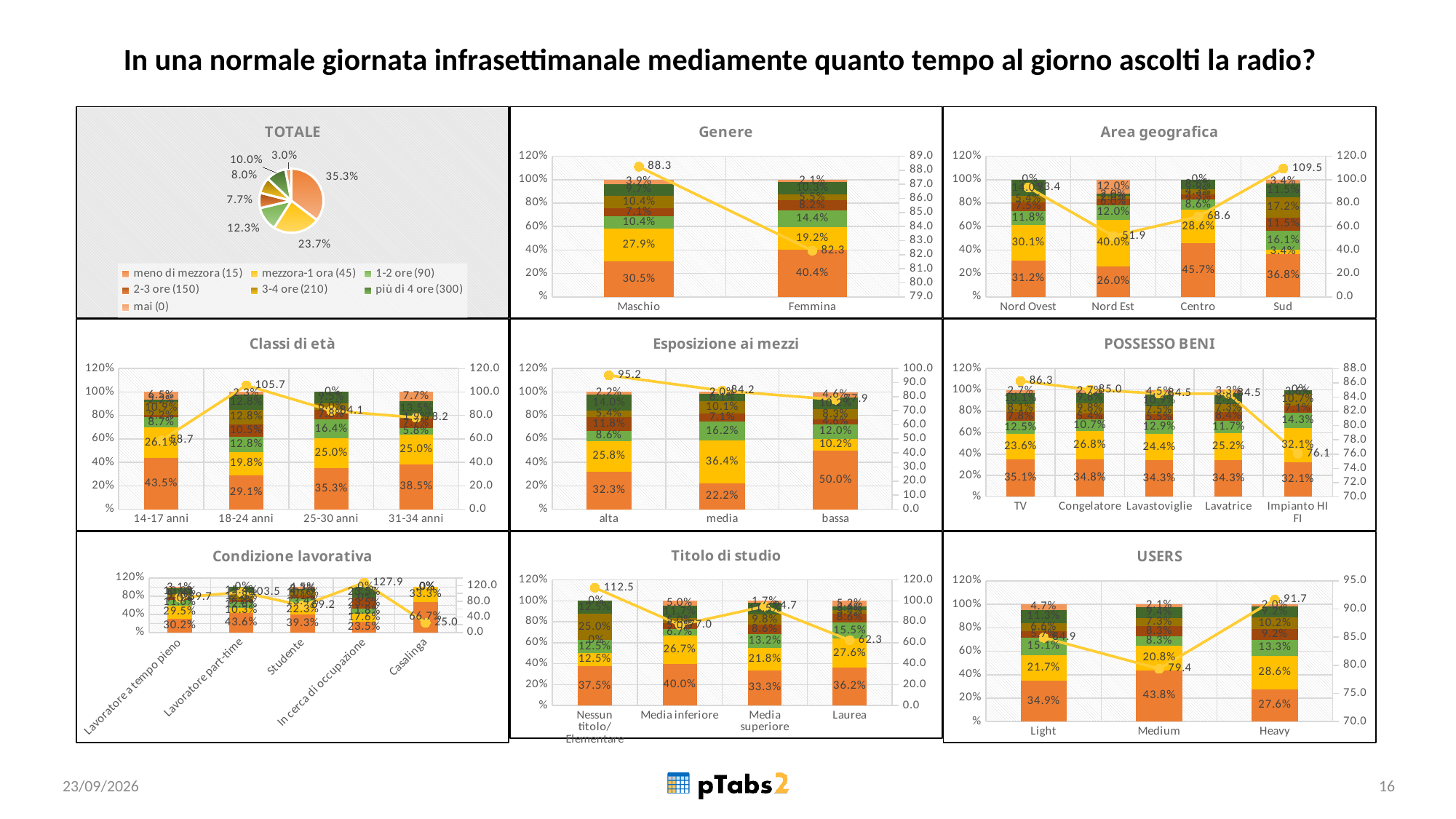
In the Esposizione ai mezzi chart, is the 'mezzora-1 ora' value larger for media or for bassa? media In the Condizione lavorativa chart, what is the line value for 'In cerca di occupazione'? 127.9 In the TOTALE pie chart, what share is shown for the largest slice? 35.3% How many entries does the legend of the TOTALE pie chart list? 7 In the Genere chart, what is the 'meno di mezzora' value for Femmina? 40.4% In the Area geografica chart, what is the line value for Sud? 109.5 How many categories are shown on the x axis of the POSSESSO BENI chart? 5 In the Genere chart, what is the difference between the 'meno di mezzora' values for Femmina and Maschio? 9.9% In the Classi di età chart, which age class has the lowest 'meno di mezzora' value? 18-24 anni In the Esposizione ai mezzi chart, what is the 'meno di mezzora' value for bassa? 50.0% In the Area geografica chart, which area has the highest 'meno di mezzora' value? Centro In the USERS chart, what is the 'meno di mezzora' value for Medium? 43.8%